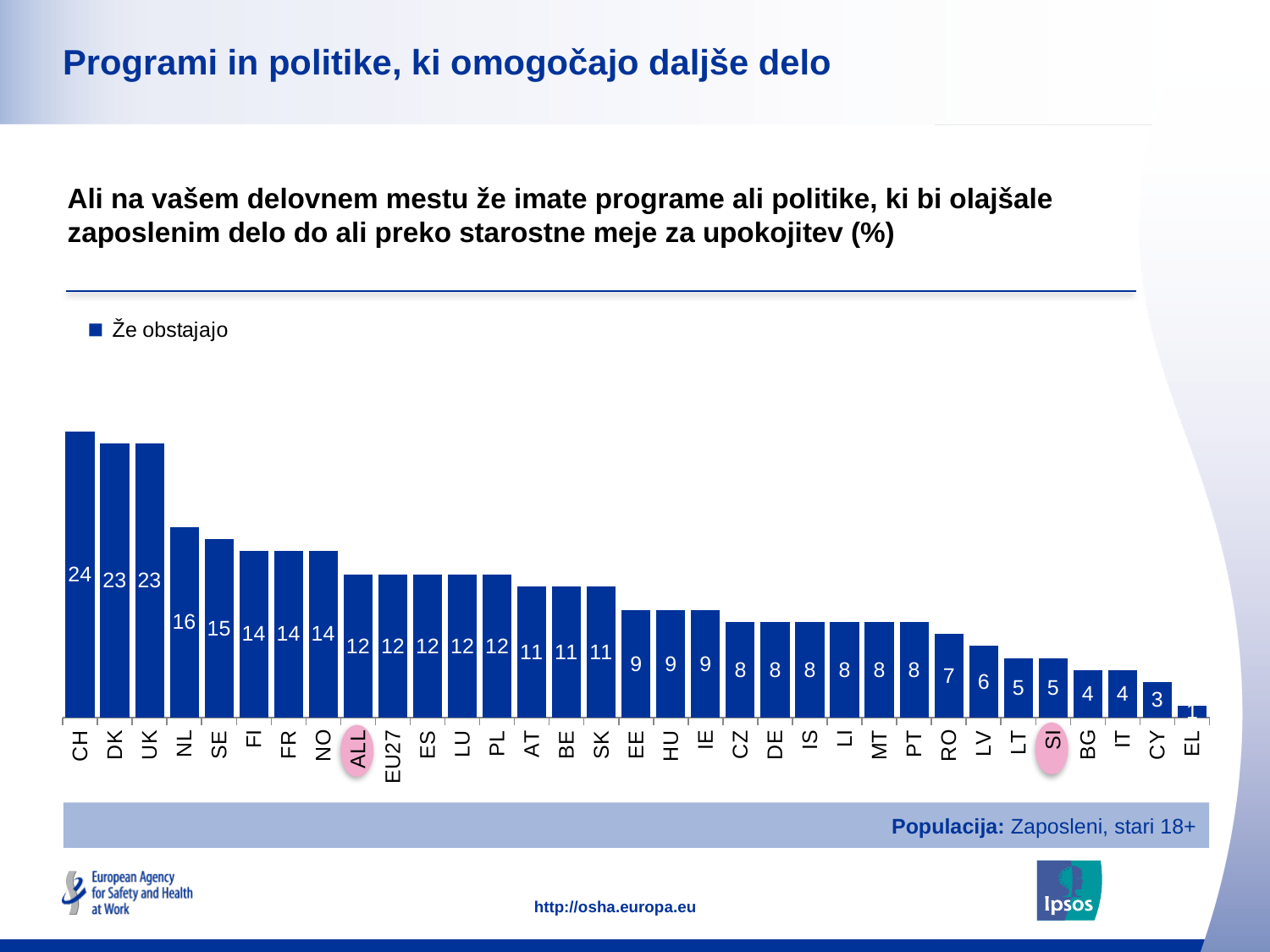
Do the values rise or fall from left to right along the x axis? fall How many categories are shown on the x axis? 33 What is the value for SI? 5 What kind of chart is shown? bar chart What is the value for CH? 24 How many series does the legend list? 1 Which has a larger value, NL or SE? NL What is the difference between the values for CH and SI? 19 Which country has the lowest value? EL Which country has the highest value? CH What is the value for RO? 7 What is the value for EU27? 12